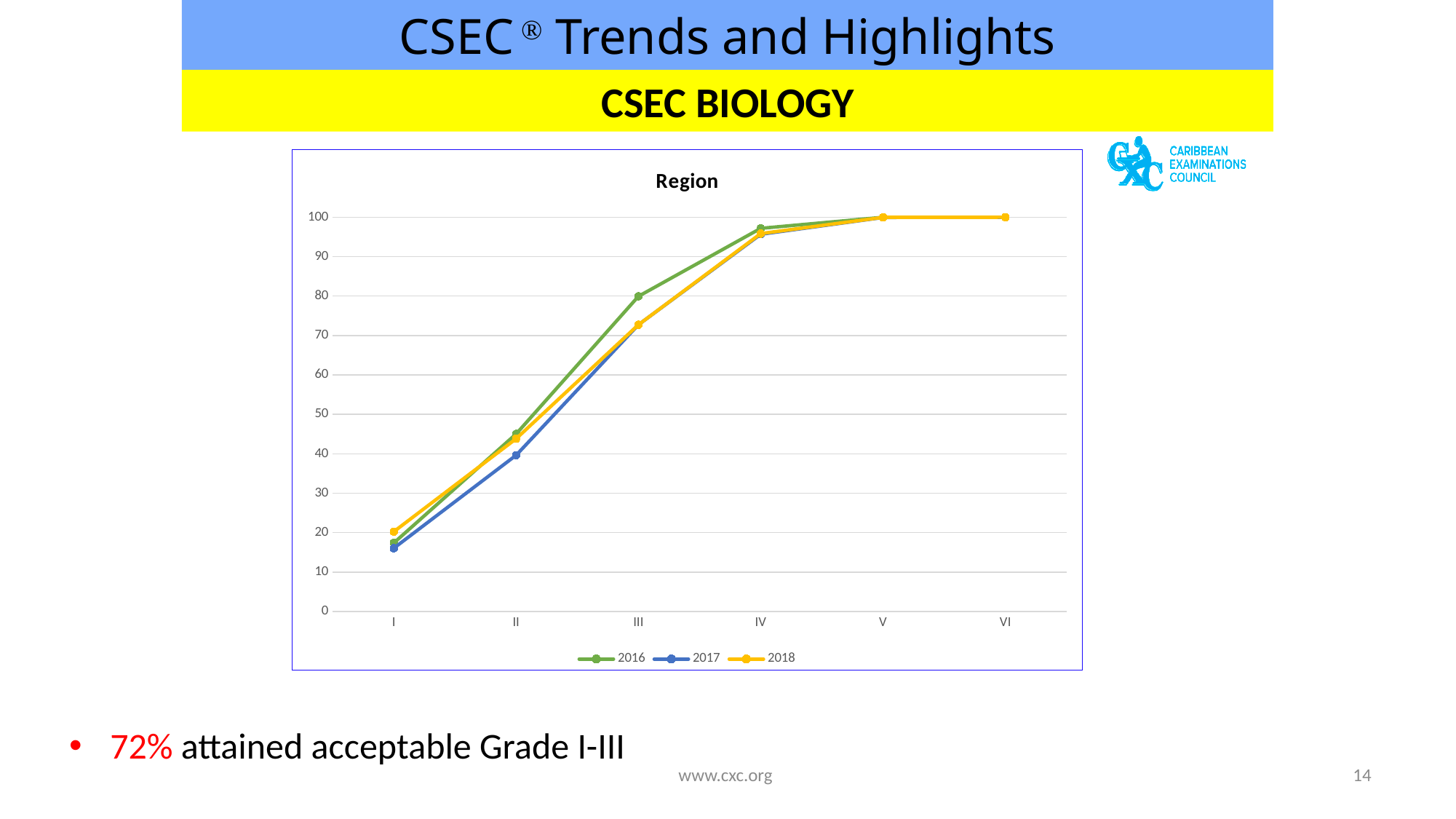
Do the values for 2017 rise or fall from category I to category VI? rise How many categories are shown along the x axis of the chart? 6 Which years are listed in the chart's legend? 2016, 2017, 2018 Which series has the lowest value at category II? 2017 What is the title of the chart? Region How many series does the chart's legend list? 3 What kind of chart is shown on the slide? line chart Is the value for 2017 at category II greater or less than 50? less What is the value for 2018 at category VI? 100 Is the value for 2016 at category III greater or less than 70? greater At category III, which series has the higher value, 2016 or 2018? 2016